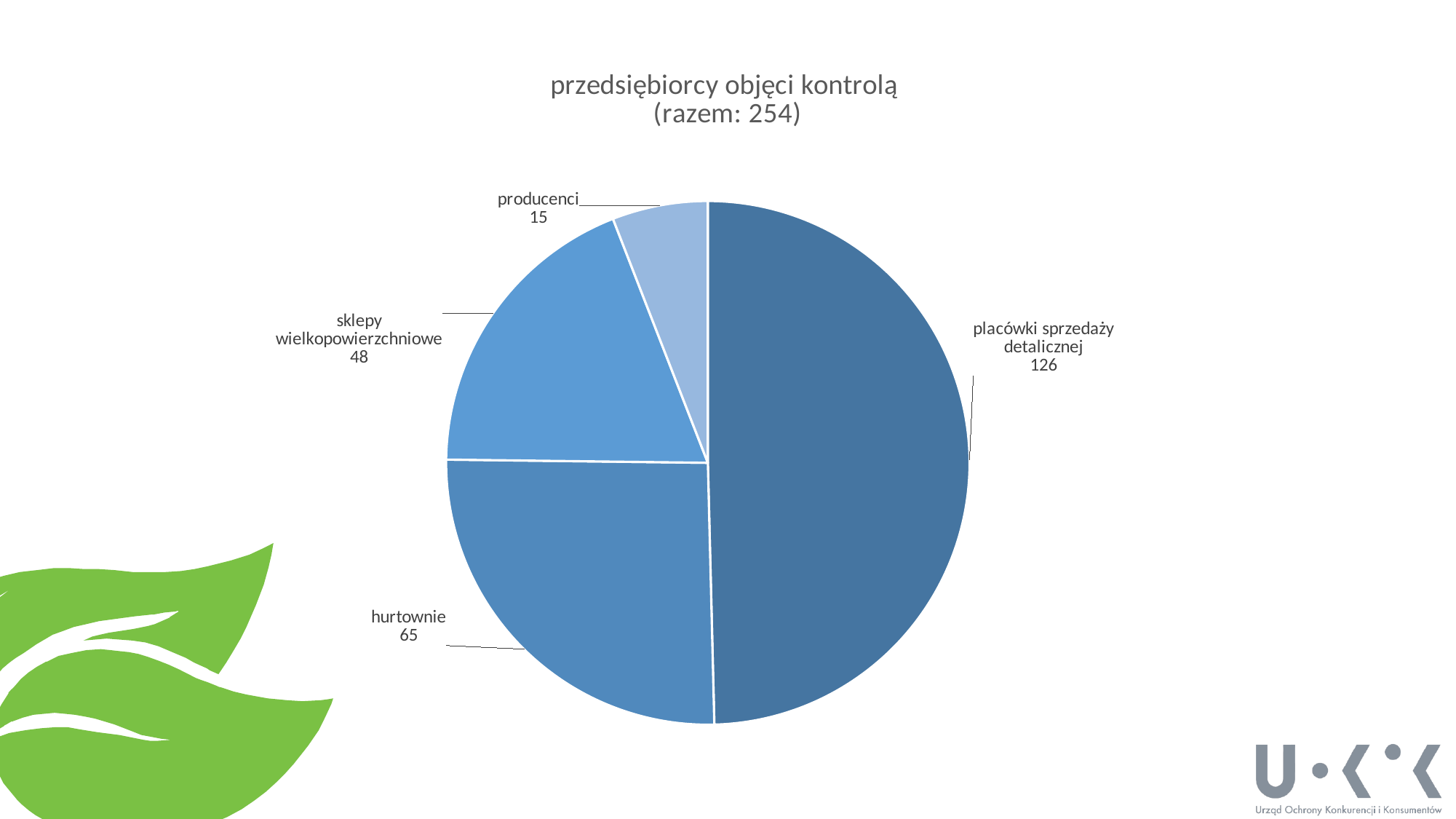
Which is larger, the value for hurtownie or the value for sklepy wielkopowierzchniowe? hurtownie What total is stated in the chart title? 254 What type of chart is shown on the slide? pie chart What is the value for sklepy wielkopowierzchniowe? 48 What is the value for placówki sprzedaży detalicznej? 126 Which category has the largest slice of the pie? placówki sprzedaży detalicznej How many categories are shown in the pie chart? 4 What is the difference between the values for placówki sprzedaży detalicznej and hurtownie? 61 Which category has the smallest slice of the pie? producenci What is the value for hurtownie? 65 What is the value for producenci? 15